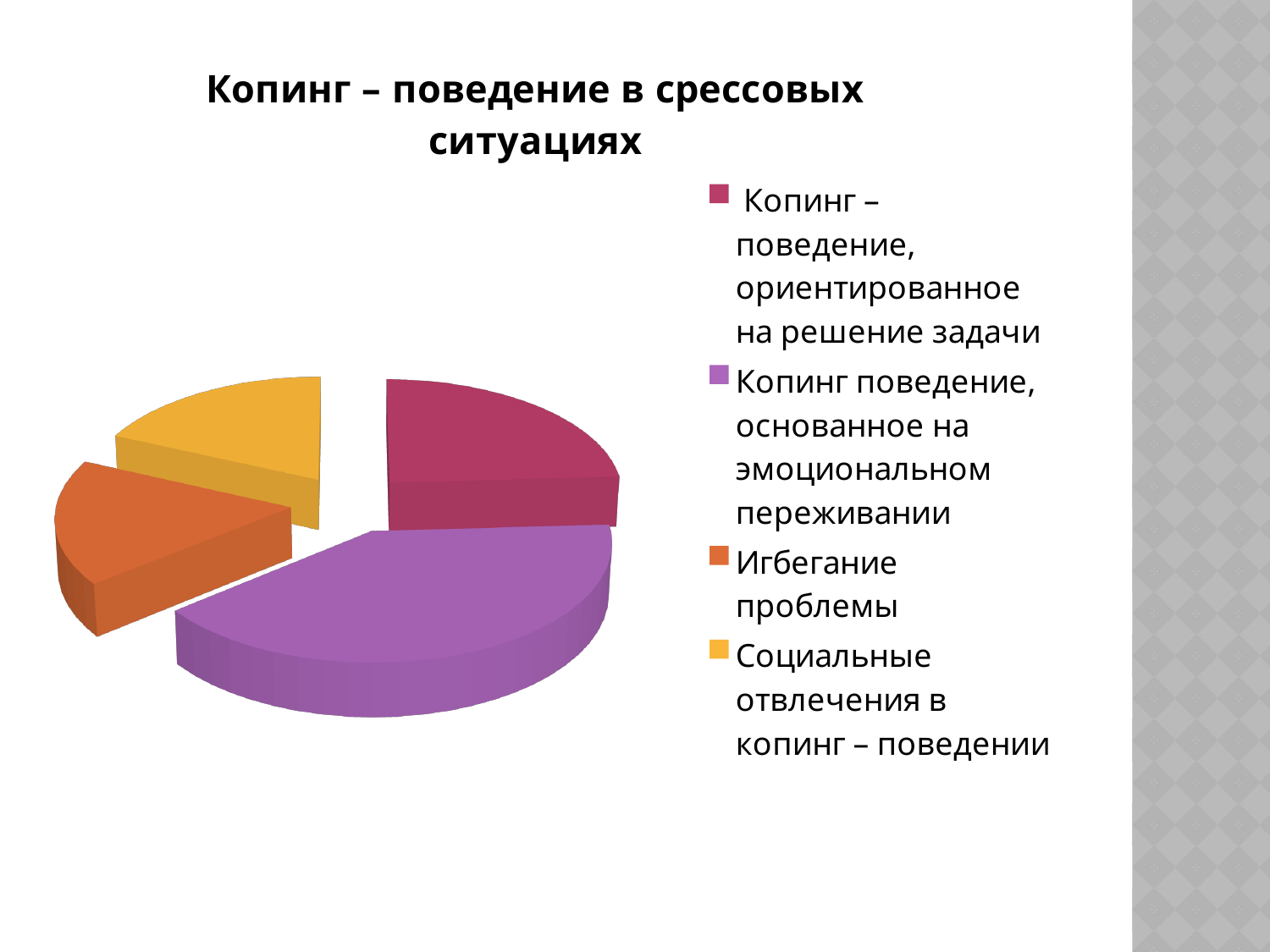
What kind of chart is shown on the slide? Pie chart What is the title of the chart on the slide? Копинг – поведение в срессовых ситуациях Which slice is larger: "Копинг поведение, основанное на эмоциональном переживании" or "Игбегание проблемы"? Копинг поведение, основанное на эмоциональном переживании Which slice is larger: "Копинг поведение, основанное на эмоциональном переживании" or "Социальные отвлечения в копинг – поведении"? Копинг поведение, основанное на эмоциональном переживании How many entries does the legend of the pie chart list? 4 Which slice is larger: "Копинг поведение, основанное на эмоциональном переживании" or "Копинг – поведение, ориентированное на решение задачи"? Копинг поведение, основанное на эмоциональном переживании Which category has the largest slice of the pie chart? Копинг поведение, основанное на эмоциональном переживании How many slices does the pie chart have? 4 What colour is the slice for "Социальные отвлечения в копинг – поведении"? Yellow